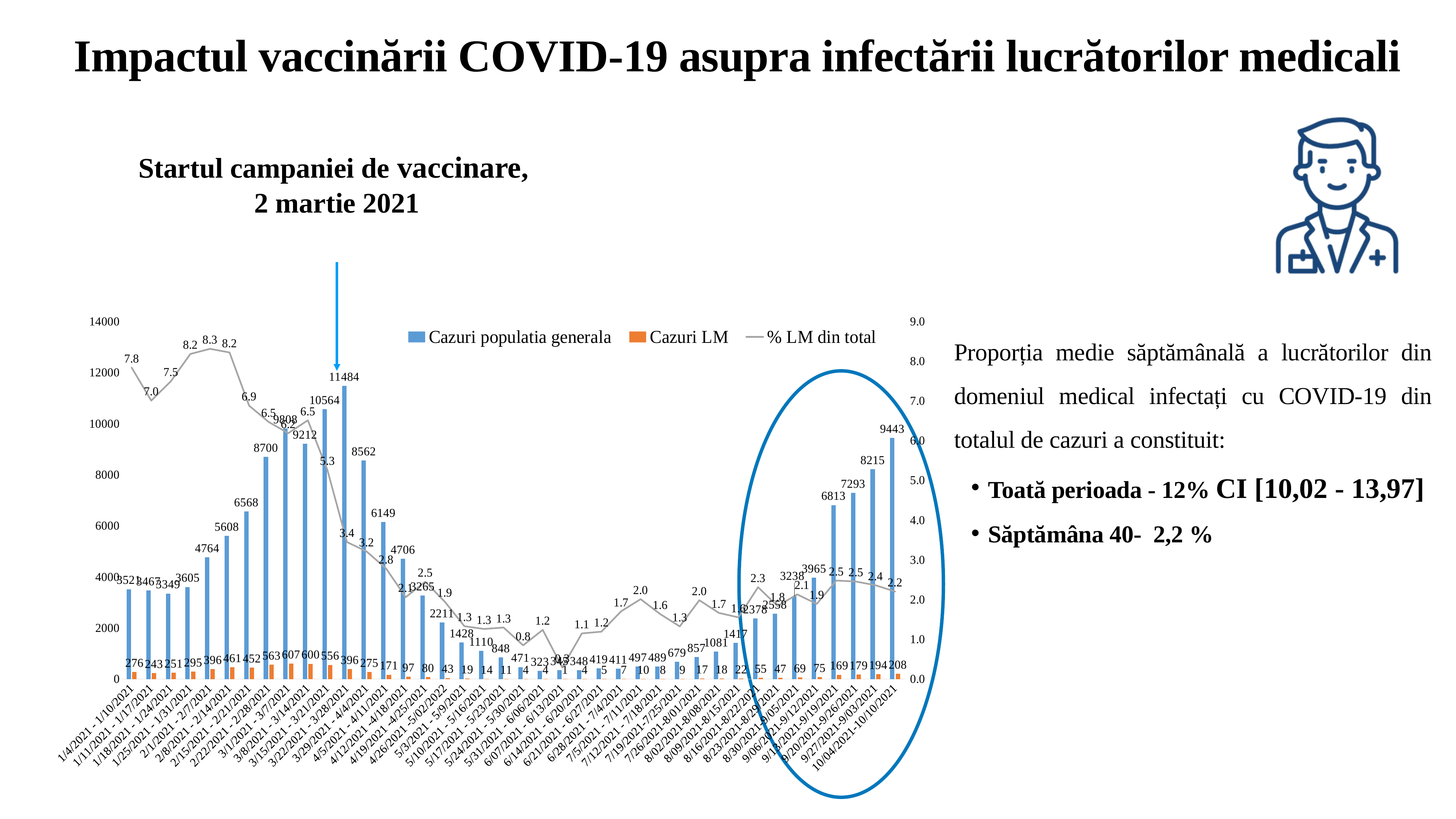
How many series does the chart legend list? 3 How many weekly periods are plotted on the x axis of the chart? 40 Which series in the legend is shown with orange bars? Cazuri LM Which week has the highest value of Cazuri populatia generala? 3/22/2021 - 3/28/2021 What is the value of Cazuri populatia generala for the week 3/22/2021 - 3/28/2021? 11484 Which week has the highest value of Cazuri LM? 3/1/2021 - 3/7/2021 What type of chart is shown on the slide? Combined bar and line chart What is the % LM din total value for the week 2/1/2021 - 2/7/2021? 8.3 What is the value of Cazuri LM for the week 10/04/2021 - 10/10/2021? 208 Does the % LM din total line generally rise or fall from the start of the chart to the week 6/14/2021 - 6/20/2021? Fall Which is larger: Cazuri populatia generala for 2/22/2021 - 2/28/2021 or for 3/8/2021 - 3/14/2021? 3/8/2021 - 3/14/2021